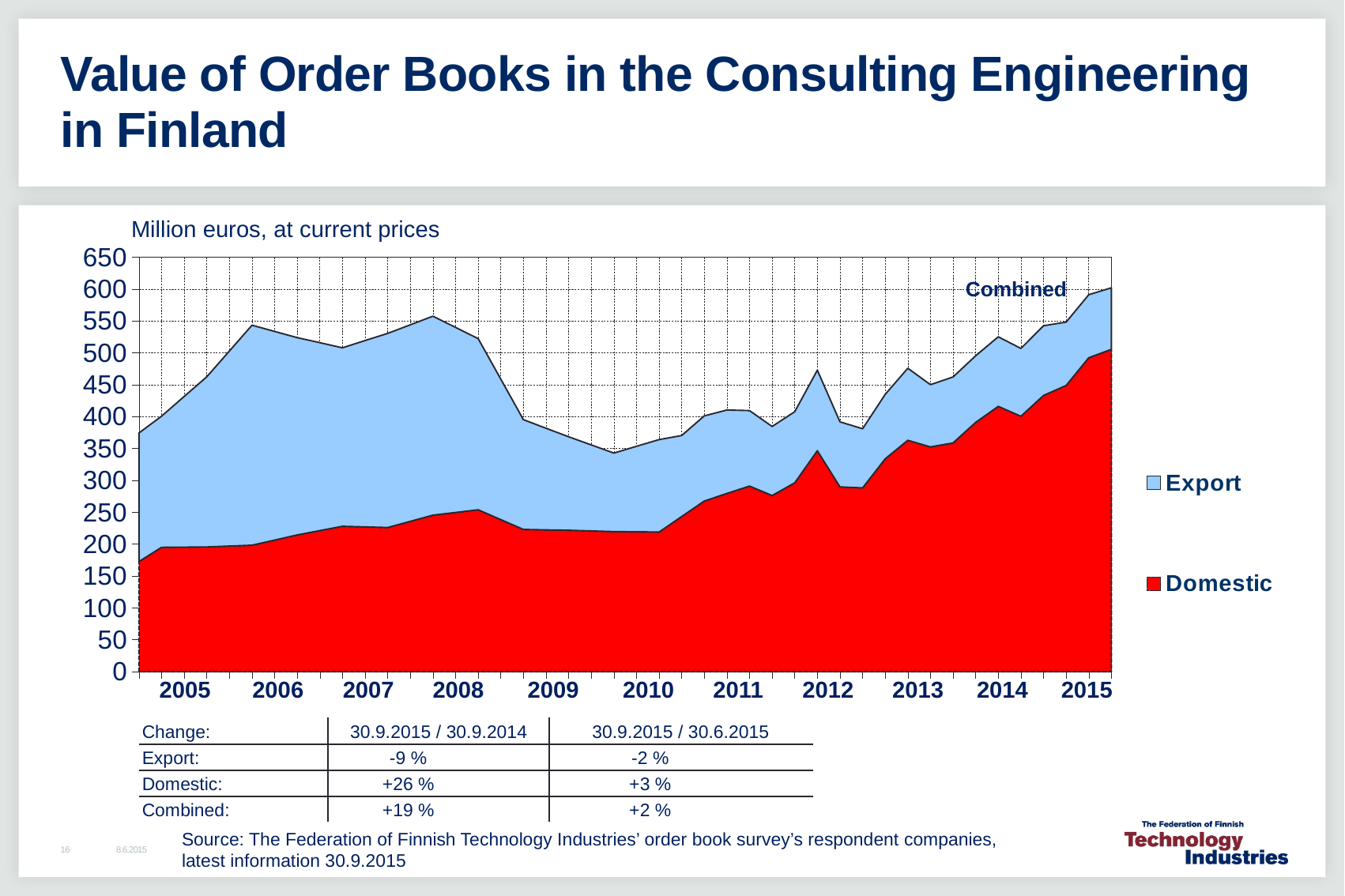
Does the Domestic value generally rise or fall from 2005 to 2015? Rise Is the Domestic value at the end of 2015 greater or less than 450? greater Is the Domestic value in 2010 greater or less than 250? less How many series does the chart's legend list? 2 In which year does the Domestic value reach its highest level? 2015 How many years are labelled on the chart's x axis? 11 At the end of 2015, which is larger, the Export value or the Domestic value? Domestic Is the Combined value at the end of 2015 greater or less than 550? greater What kind of chart is shown on the slide? Stacked area chart What are the two series named in the chart's legend? Export and Domestic What unit is the chart's vertical axis measured in, according to the label above the chart? Million euros, at current prices